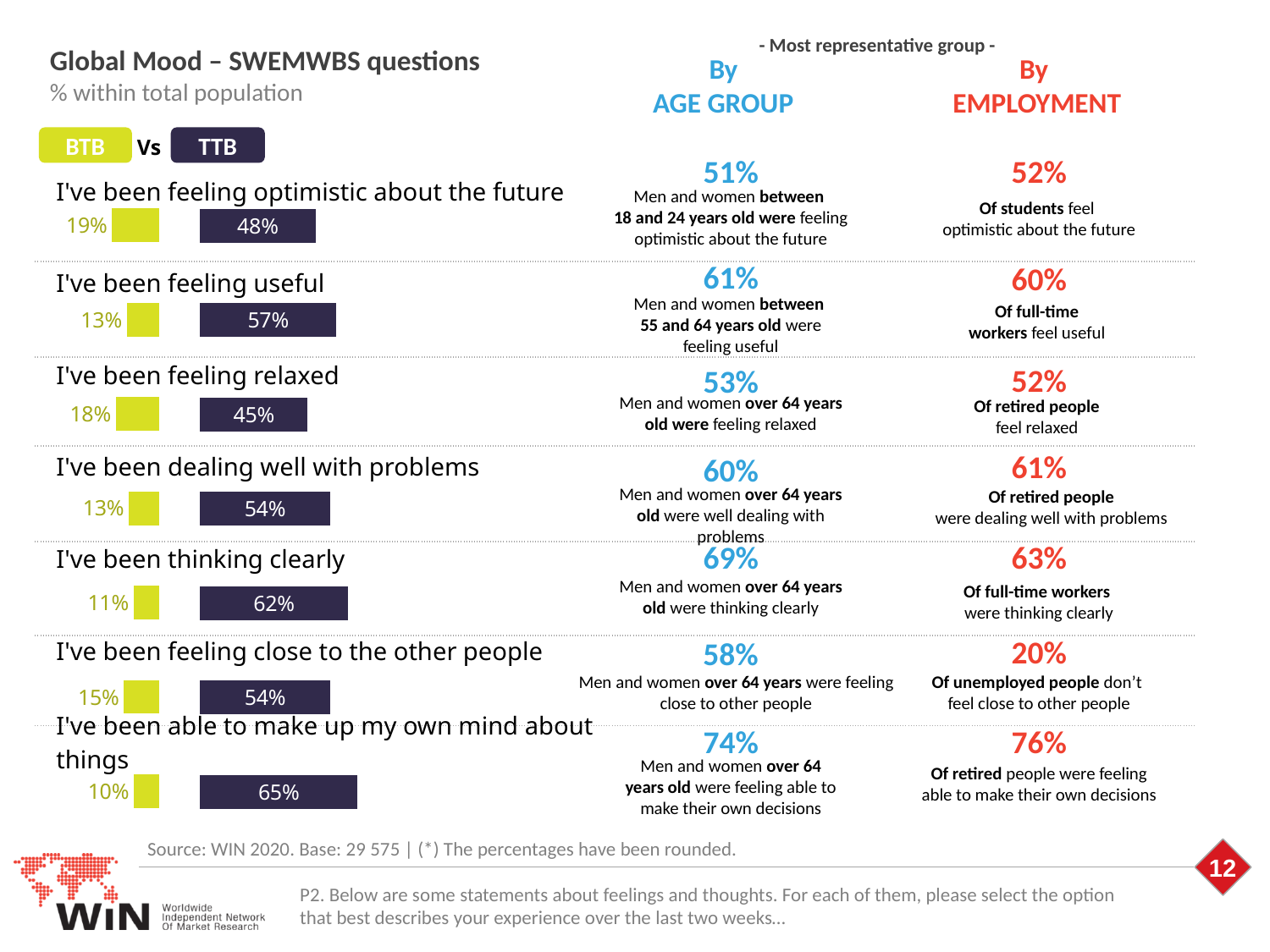
What is the BTB value for "I've been feeling useful"? 13% Which is larger: the TTB value for "I've been feeling useful" or the TTB value for "I've been feeling relaxed"? I've been feeling useful What is the difference between the TTB and BTB values for "I've been feeling optimistic about the future"? 29 percentage points Which statement has the lowest TTB value? I've been feeling relaxed How many statements are shown with BTB vs TTB bars? 7 What is the TTB value for "I've been thinking clearly"? 62% How many series does the BTB vs TTB legend show? 2 Which statement has the highest BTB value? I've been feeling optimistic about the future Which statement has the highest TTB value? I've been able to make up my own mind about things What is the TTB value for "I've been feeling optimistic about the future"? 48% What kind of chart is used to show the BTB and TTB values? Bar chart What is the BTB value for "I've been able to make up my own mind about things"? 10%